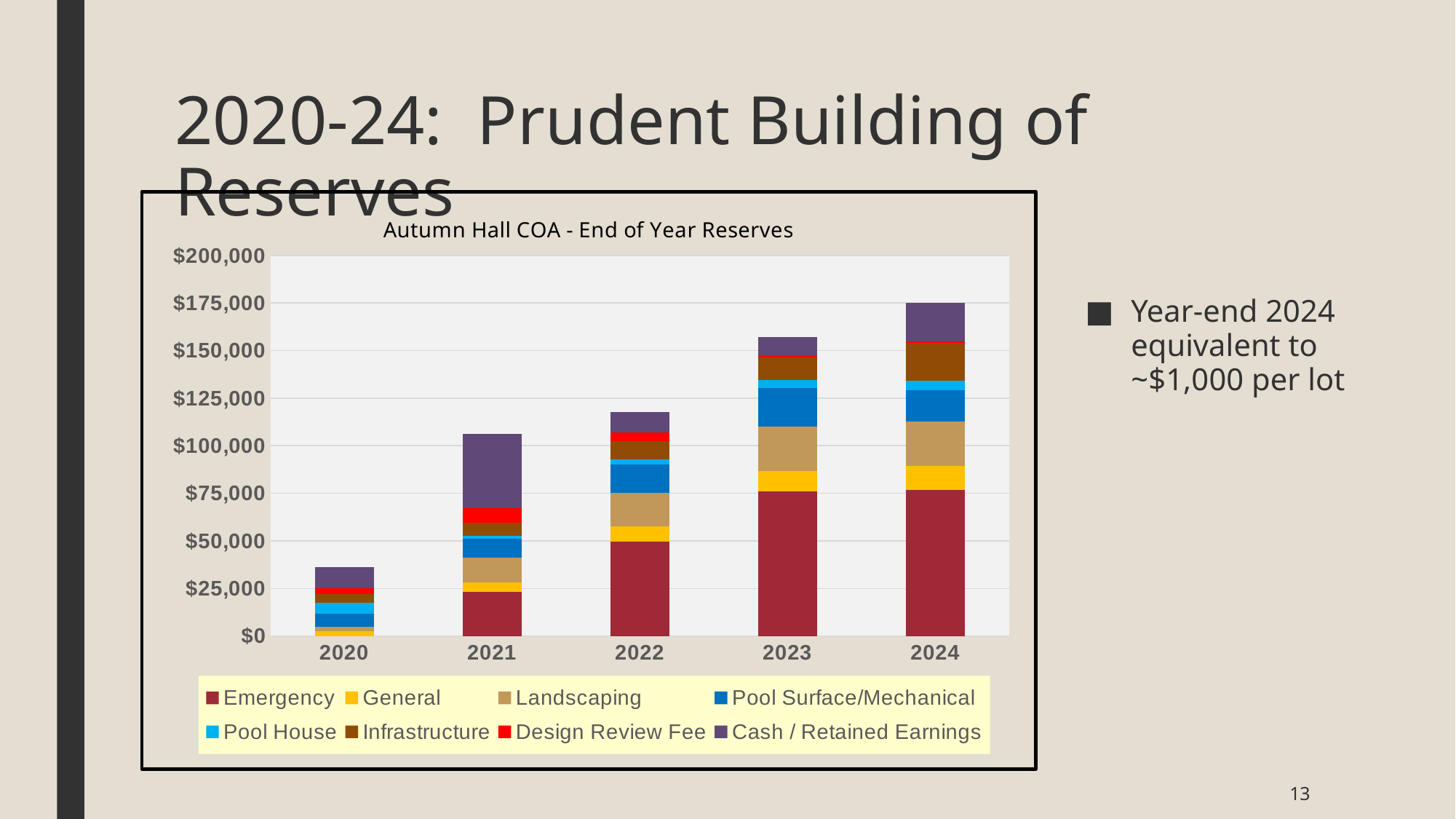
Do the total reserves rise or fall from 2020 to 2024? Rise What is the title of the chart? Autumn Hall COA - End of Year Reserves Which series is shown in dark red at the bottom of each bar? Emergency Which year has the larger Cash / Retained Earnings segment, 2021 or 2022? 2021 Which year has the highest total end-of-year reserves? 2024 How many series does the chart's legend list? 8 What kind of chart is shown on the slide? Stacked bar chart Is the total reserve for 2022 greater or less than $125,000? less Is the total reserve for 2023 greater or less than $150,000? greater Is the total reserve for 2020 greater or less than $50,000? less How many years are shown on the x axis of the chart? 5 Which year has the lowest total end-of-year reserves? 2020